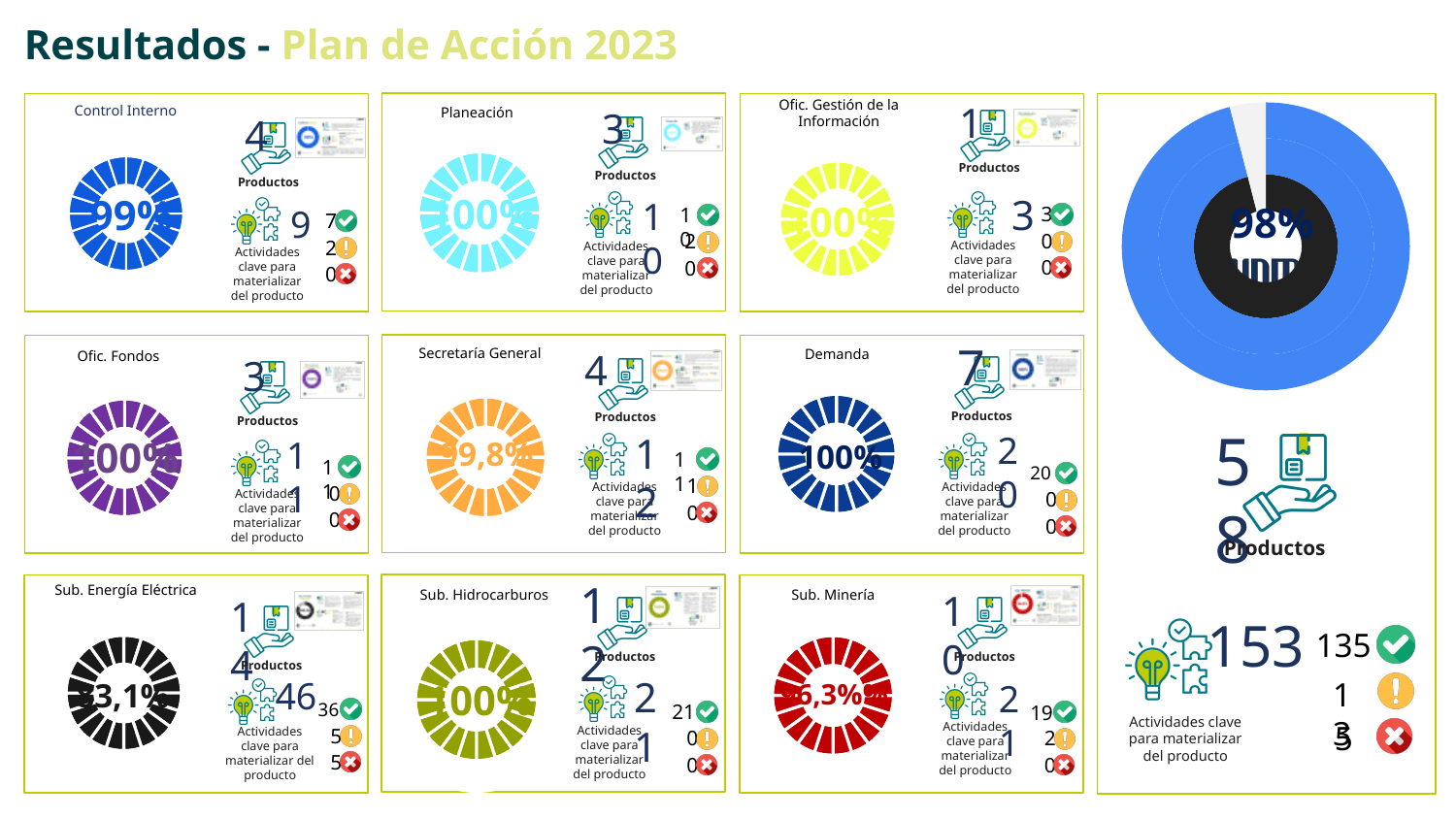
What percentage is shown in the Sub. Energía Eléctrica donut chart? 83,1% In the Control Interno panel, how many key activities (Actividades clave) are listed? 9 Which panel's donut chart shows the lowest percentage? Sub. Energía Eléctrica What type of chart is used for the Control Interno panel? donut chart What percentage is shown in the Secretaría General donut chart? 99,8% What percentage is shown in the large blue donut chart on the right of the slide? 98% What percentage is shown in the Demanda donut chart? 100% What percentage is shown in the Sub. Minería donut chart? 96,3% In the Sub. Energía Eléctrica panel, how many key activities are marked with a green check? 36 Which donut chart shows a higher percentage, Sub. Minería or Sub. Energía Eléctrica? Sub. Minería In the summary on the right, how many key activities (Actividades clave) are shown in total? 153 What percentage is shown in the Control Interno donut chart? 99%